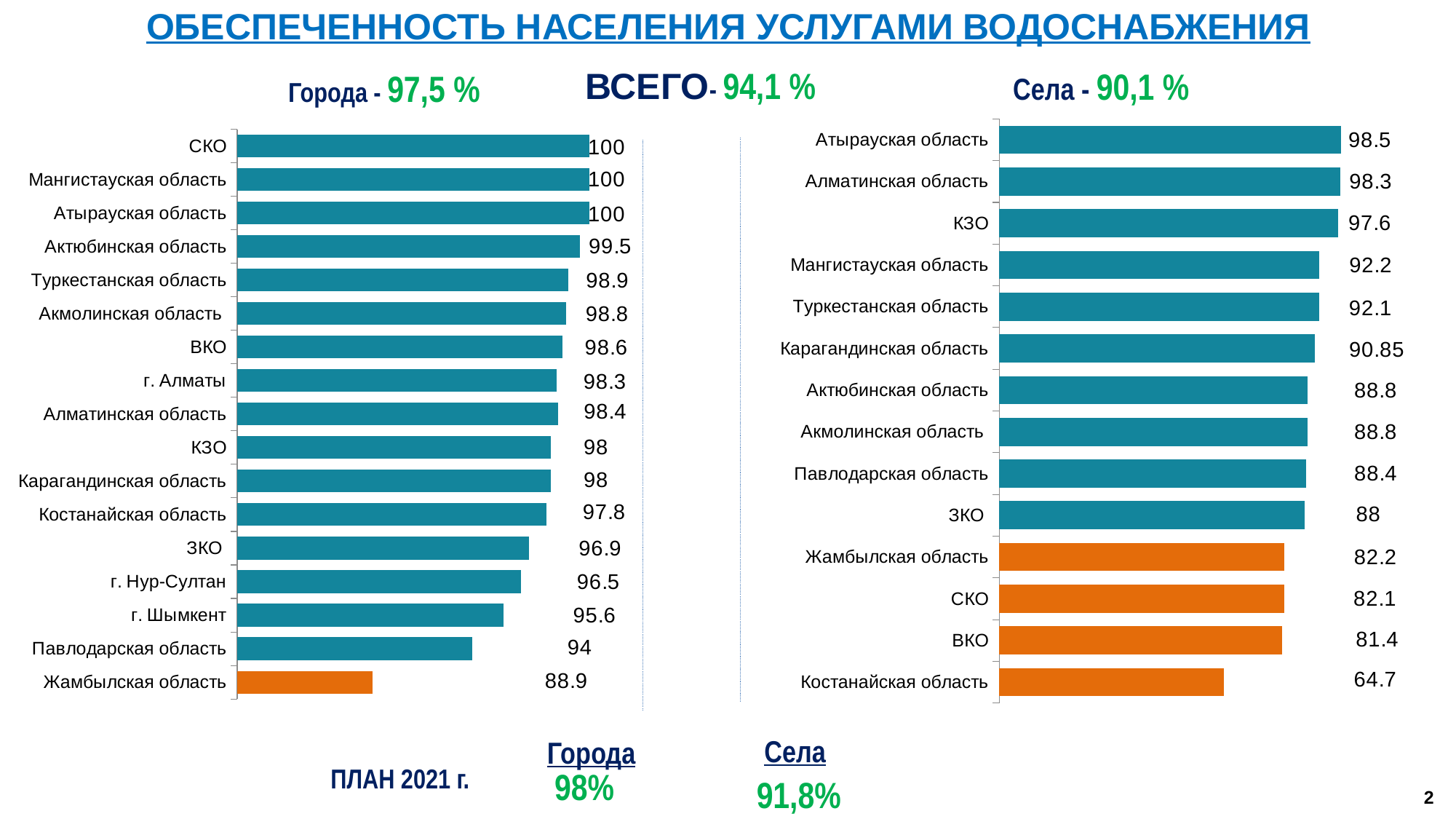
In the 'Села' chart on the right, which category has the lowest value? Костанайская область In the 'Города' chart on the left, which category has the lowest value? Жамбылская область In the 'Города' chart on the left, what is the difference between the values for СКО and Жамбылская область? 11.1 In the 'Села' chart on the right, what is the value for ЗКО? 88 In the 'Села' chart on the right, how many categories are shown? 14 In the 'Города' chart on the left, what is the value for г. Шымкент? 95.6 In the 'Села' chart on the right, which is larger: the value for Мангистауская область or the value for Жамбылская область? Мангистауская область In the 'Города' chart on the left, what is the value for Павлодарская область? 94 In the 'Села' chart on the right, what is the value for Карагандинская область? 90.85 What type of chart is the 'Села' chart on the right? Bar chart In the 'Села' chart on the right, which category has the highest value? Атырауская область In the 'Города' chart on the left, how many categories are shown? 17